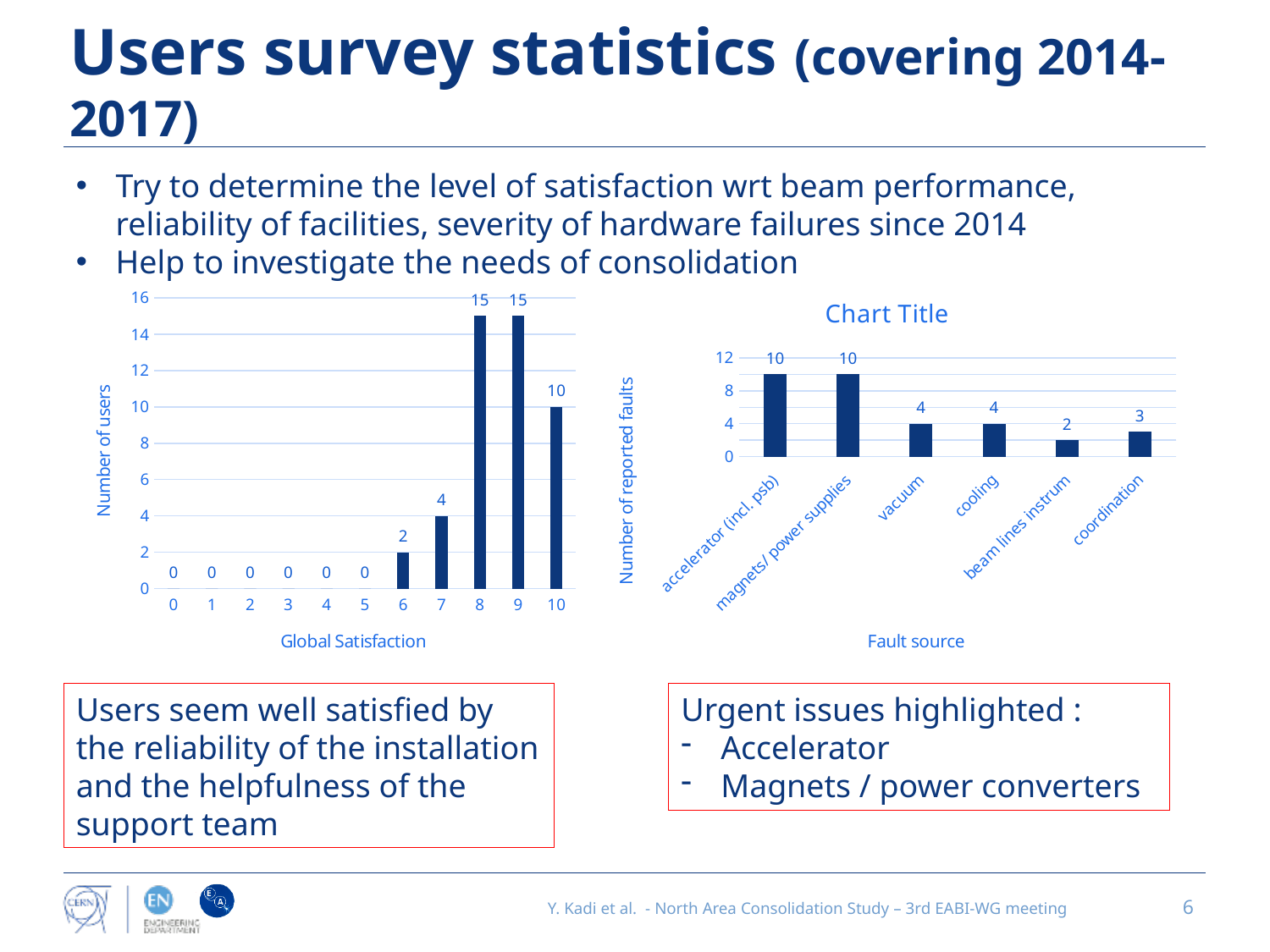
In the right chart (Fault source), which fault source has the lowest number of reported faults? beam lines instrum In the right chart (Fault source), which has more reported faults, cooling or coordination? cooling What type of chart is the right chart (Fault source)? bar chart In the left chart (Global Satisfaction), how many users gave a satisfaction score of 6? 2 In the right chart (Fault source), how many fault source categories are shown? 6 In the left chart (Global Satisfaction), what is the label of the y axis? Number of users In the left chart (Global Satisfaction), what is the difference between the number of users scoring 9 and the number scoring 7? 11 In the right chart (Fault source), how many reported faults are attributed to vacuum? 4 In the left chart (Global Satisfaction), how many users gave a satisfaction score of 10? 10 In the left chart (Global Satisfaction), how many users gave a satisfaction score of 8? 15 In the right chart (Fault source), how many reported faults are attributed to coordination? 3 In the left chart (Global Satisfaction), how many satisfaction score categories are shown on the x axis? 11